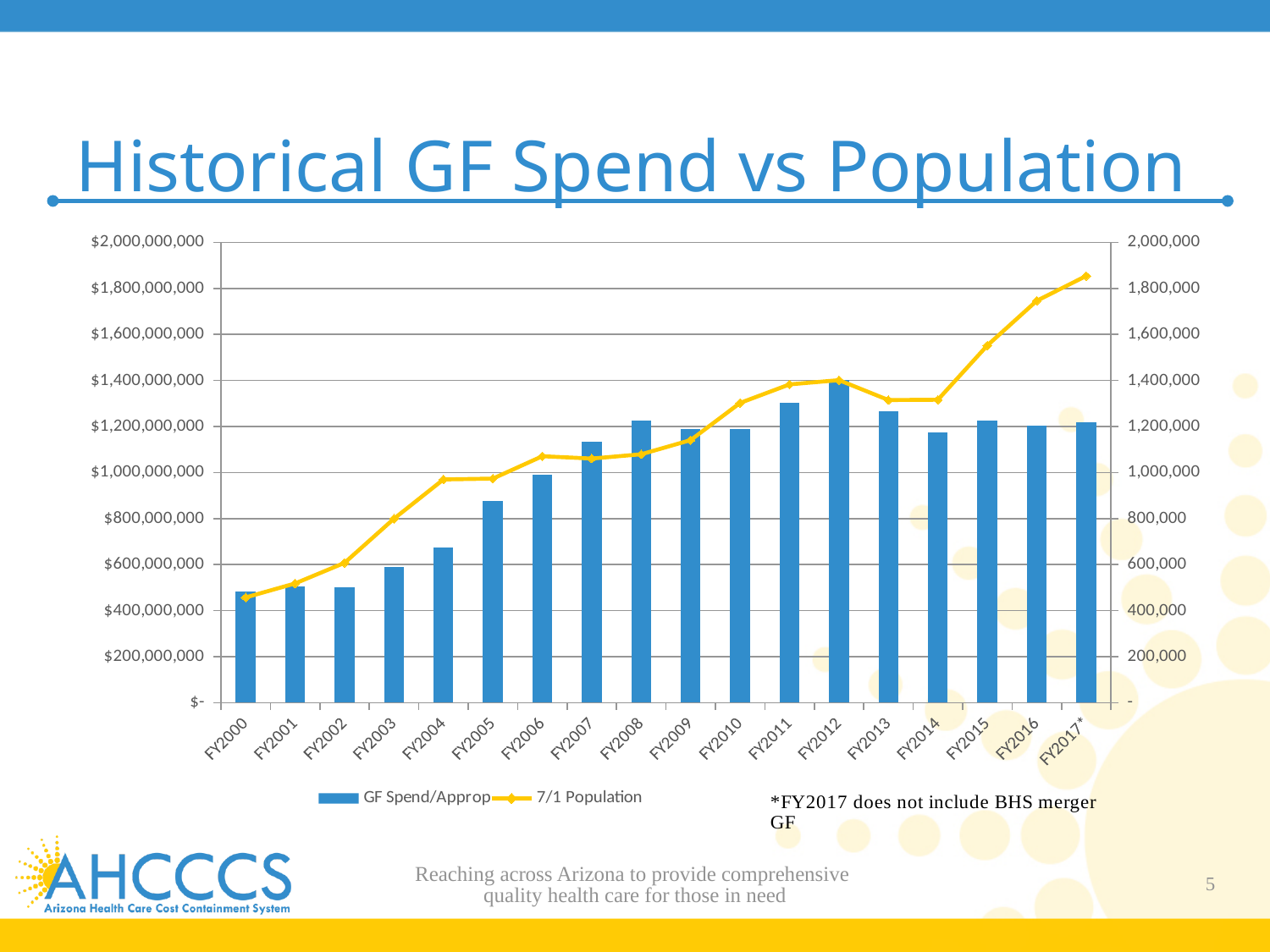
Which fiscal year has the highest 7/1 Population value? FY2017* Is the GF Spend/Approp value for FY2005 greater or less than $1,000,000,000? less What kind of chart is shown on the slide? A combined bar and line chart How many fiscal years are shown on the x axis? 18 Is the GF Spend/Approp value for FY2012 greater or less than $1,200,000,000? greater Is the GF Spend/Approp value for FY2000 greater or less than $600,000,000? less Which fiscal year has the highest GF Spend/Approp bar? FY2012 Which has the larger GF Spend/Approp bar, FY2012 or FY2014? FY2012 How many series does the legend list? 2 Which fiscal year has the lowest 7/1 Population value? FY2000 Does the 7/1 Population line generally rise or fall from FY2000 to FY2017*? rise